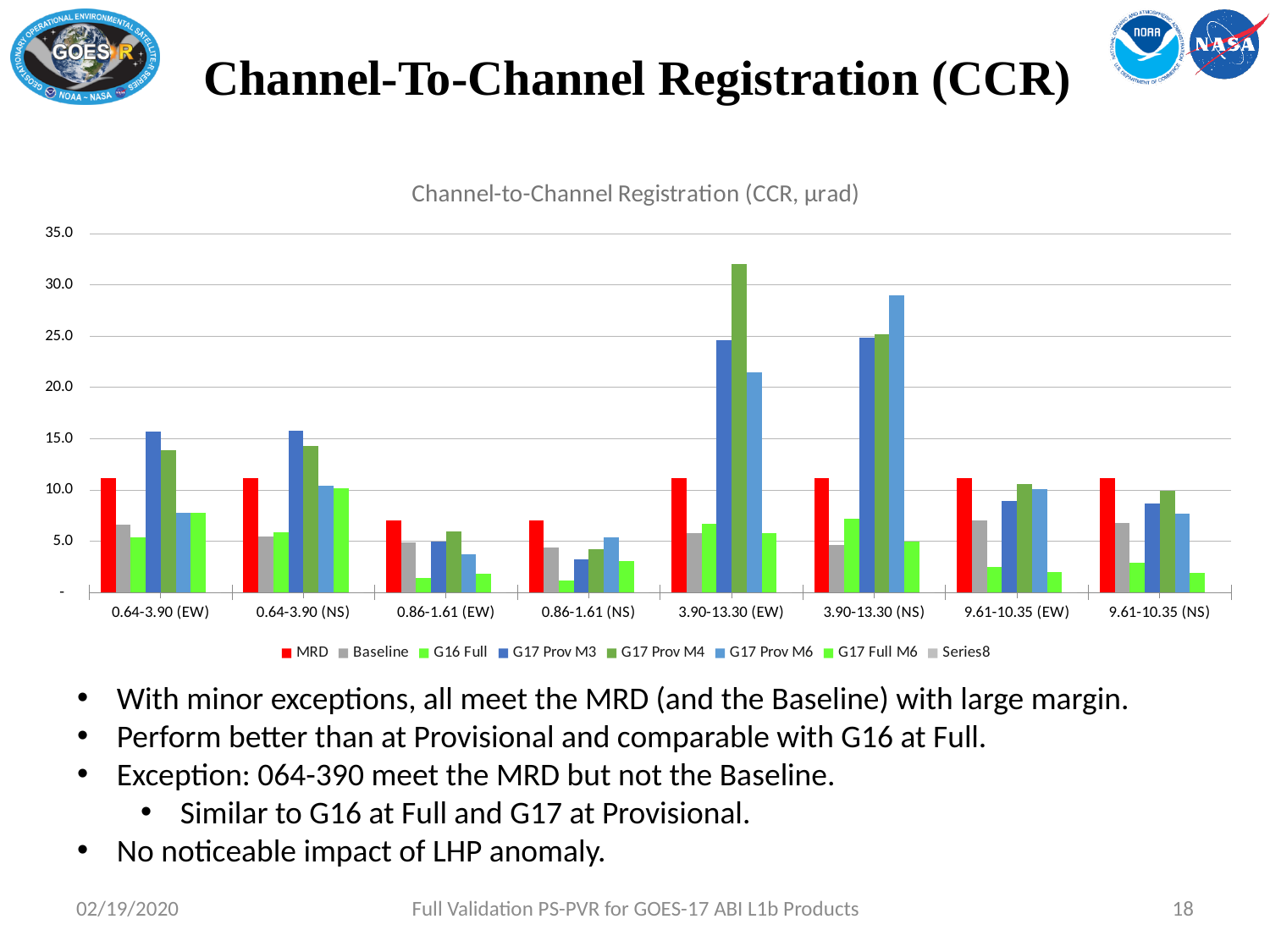
Is the value for MRD in the 0.64-3.90 (EW) category greater or less than 10.0? greater Which series has the tallest bar in the whole chart? G17 Prov M4 How many categories are shown along the x axis? 8 Is the value for G17 Full M6 in the 0.86-1.61 (EW) category greater or less than 5.0? less In the 3.90-13.30 (EW) category, which is larger: G17 Prov M4 or G17 Prov M6? G17 Prov M4 What colour are the MRD bars? Red How many series does the chart legend list? 8 Is the value for G17 Prov M6 in the 3.90-13.30 (NS) category greater or less than 25.0? greater What kind of chart is shown on the slide? Bar chart In the 3.90-13.30 (NS) category, which series has the highest bar? G17 Prov M6 What is the title of the chart? Channel-to-Channel Registration (CCR, μrad)